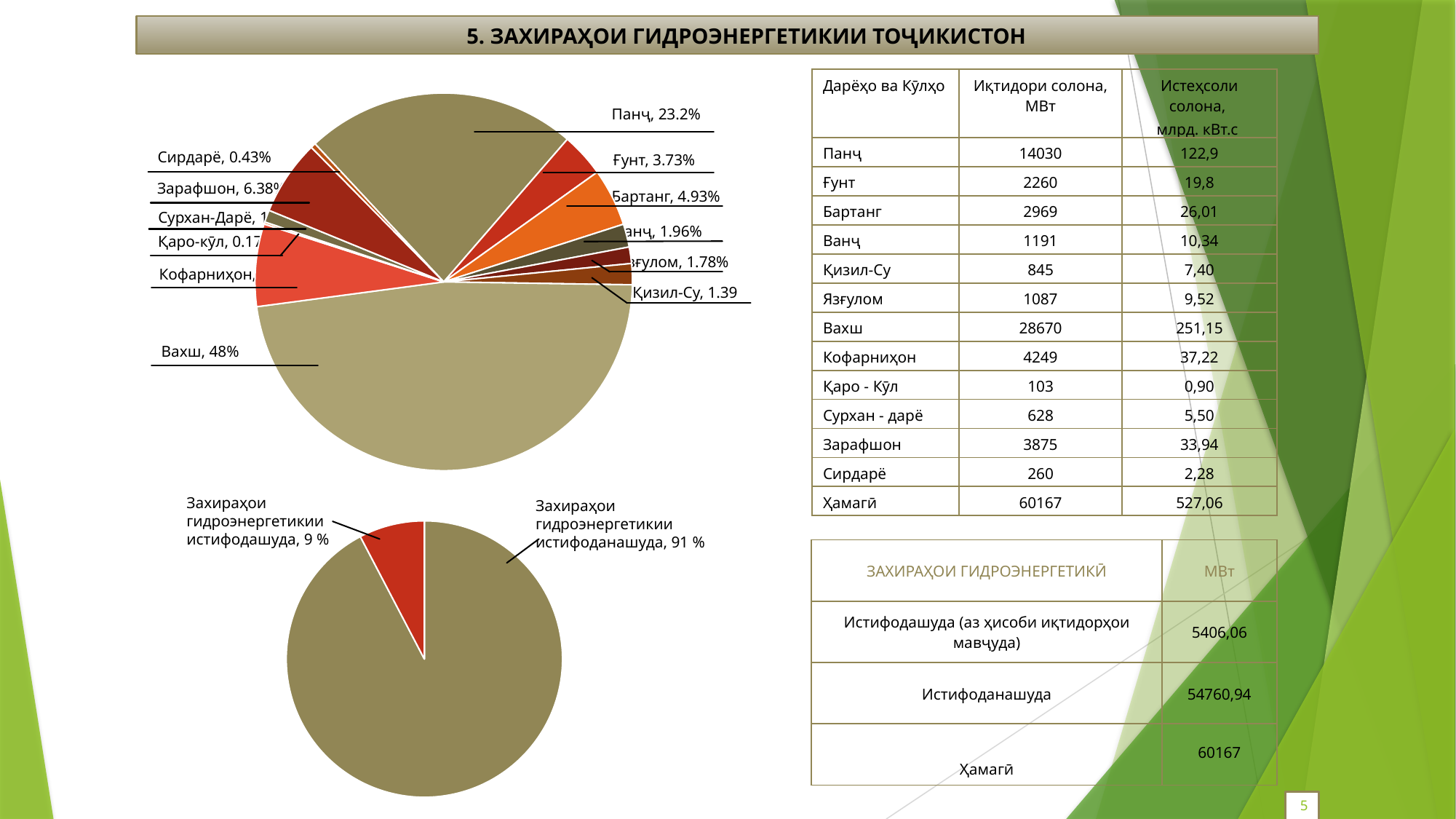
In the top pie chart, what share does Бартанг have? 4.93% In the top pie chart, what share does Панҷ have? 23.2% In the top pie chart, what share does Вахш have? 48% In the top pie chart, how many slices are there? 12 What kind of chart is the top chart on the slide? Pie chart In the bottom pie chart, how many slices are there? 2 In the bottom pie chart, what share is labelled Захираҳои гидроэнергетикии истифодашуда? 9 % In the top pie chart, what share does Зарафшон have? 6.38% In the top pie chart, what is the difference in percentage points between Панҷ and Ғунт? 19.47 In the top pie chart, which river has the largest slice? Вахш In the bottom pie chart, what share is labelled Захираҳои гидроэнергетикии истифоданашуда? 91 % In the top pie chart, which is larger, the slice for Ғунт or the slice for Бартанг? Бартанг